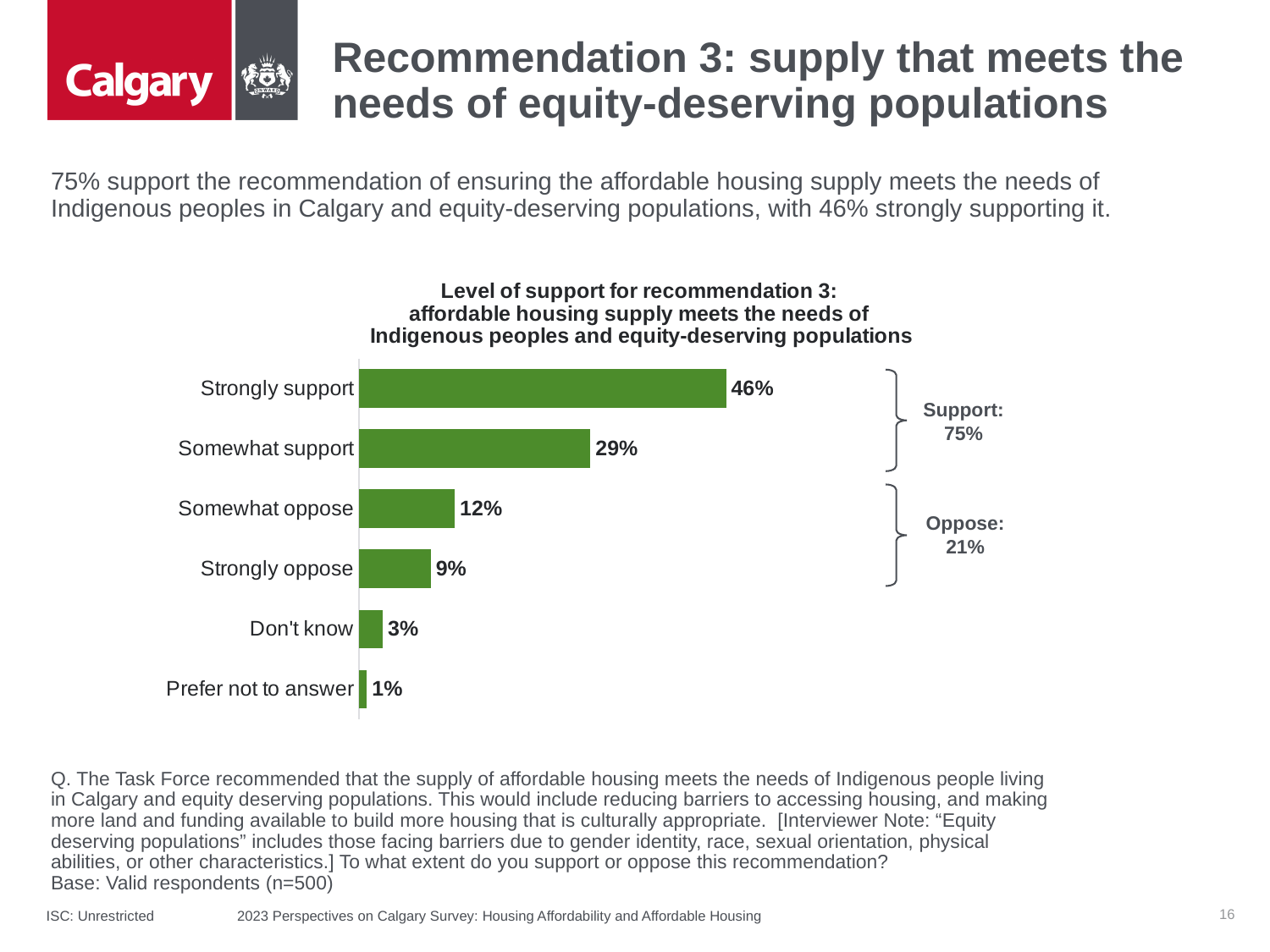
What is the difference in percentage points between 'Strongly support' and 'Somewhat support'? 17 What percentage of respondents strongly support recommendation 3? 46% Which is larger, the percentage for 'Somewhat support' or for 'Somewhat oppose'? Somewhat support What is the combined percentage shown for 'Oppose' on the chart? 21% How many response categories are shown in the chart? 6 What percentage of respondents answered 'Don't know'? 3% What kind of chart is shown on the slide? Bar chart What percentage of respondents somewhat oppose recommendation 3? 12% What is the difference in percentage points between 'Somewhat oppose' and 'Strongly oppose'? 3 Which response category has the lowest percentage? Prefer not to answer What colour are the bars in the chart? Green Which response category has the highest percentage? Strongly support